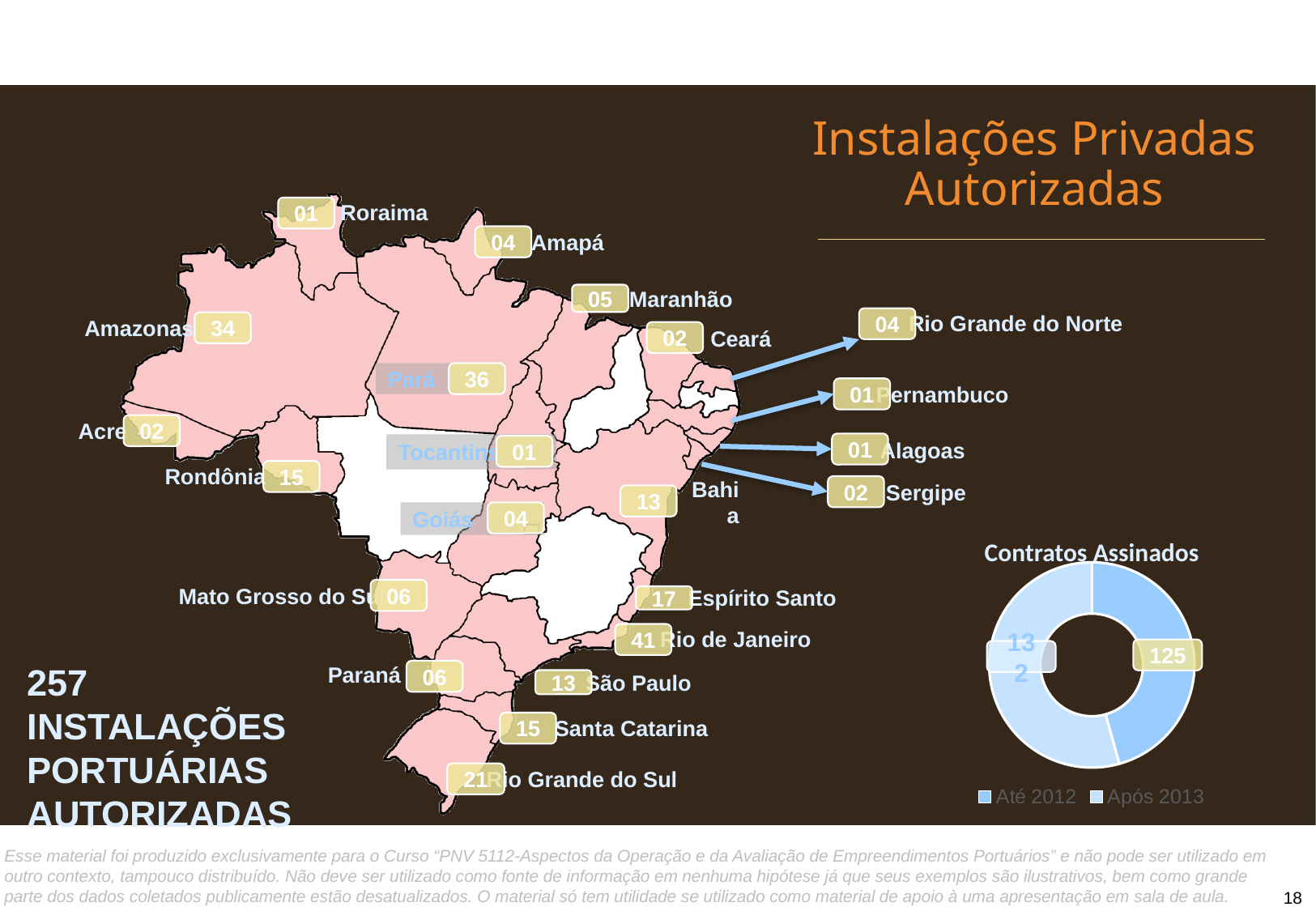
In the 'Contratos Assinados' chart, what is the value for 'Até 2012'? 125 On the map of Brazil, what is the number shown for Rio de Janeiro? 41 In the 'Contratos Assinados' chart, which segment is larger, 'Até 2012' or 'Após 2013'? Após 2013 What is the title of the doughnut chart on the right of the slide? Contratos Assinados In the 'Contratos Assinados' chart, what is the difference between the 'Após 2013' and 'Até 2012' values? 7 How many entries does the legend of the 'Contratos Assinados' chart list? 2 On the map of Brazil, which state has the highest number shown? Rio de Janeiro In the 'Contratos Assinados' chart, which legend entry is shown in the darker blue? Até 2012 On the map of Brazil, what is the number shown for Pará? 36 In the 'Contratos Assinados' chart, what is the total of the two segments? 257 What type of chart is the 'Contratos Assinados' chart? doughnut chart In the 'Contratos Assinados' chart, what is the value for 'Após 2013'? 132